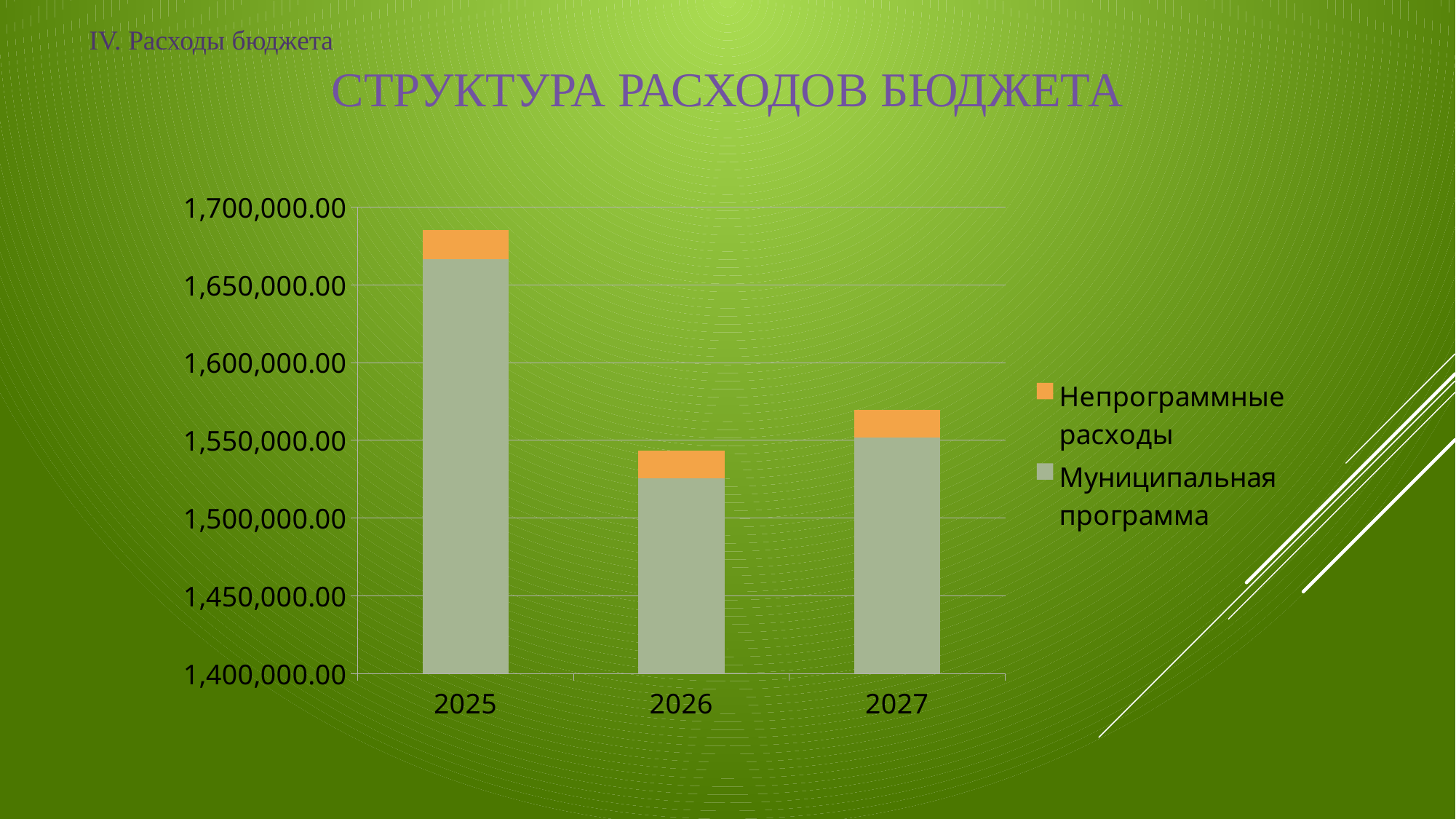
Which year has the lowest total bar? 2026 What kind of chart is shown on the slide? Stacked bar chart Is the total bar for 2025 greater or less than 1,650,000.00? greater Is the total bar for 2026 greater or less than 1,550,000.00? less How many years are shown on the x axis of the chart? 3 Which series is shown in orange in the chart legend? Непрограммные расходы How many series does the chart legend list? 2 Which total bar is taller, 2025 or 2027? 2025 Is the total bar for 2027 greater or less than 1,550,000.00? greater Which year has the highest total bar? 2025 Does the total bar rise or fall from 2025 to 2026? fall